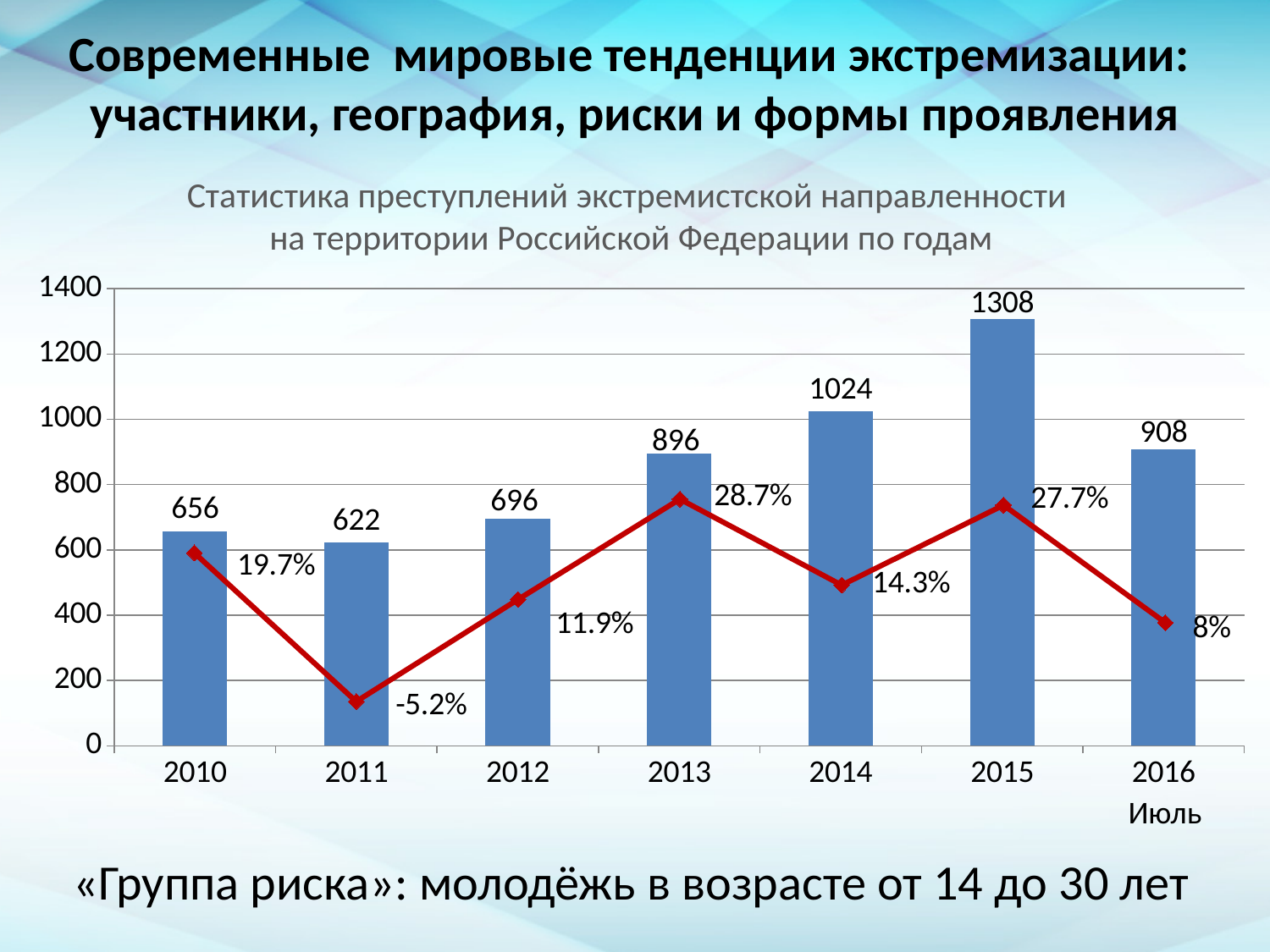
What is the bar value for 2011? 622 Do the bar values rise or fall from 2011 to 2015? rise What is the difference between the bar values for 2015 and 2014? 284 What percentage is labelled on the red line for 2013? 28.7% What percentage is labelled on the red line for 2011? -5.2% Which year has the highest bar value? 2015 What is the bar value for 2015? 1308 How many years are shown on the x axis? 7 Which is larger, the bar value for 2012 or for 2010? 2012 Is the bar value for 2014 greater or less than 1000? greater What is the title of the chart? Статистика преступлений экстремистской направленности на территории Российской Федерации по годам Which year has the lowest bar value? 2011